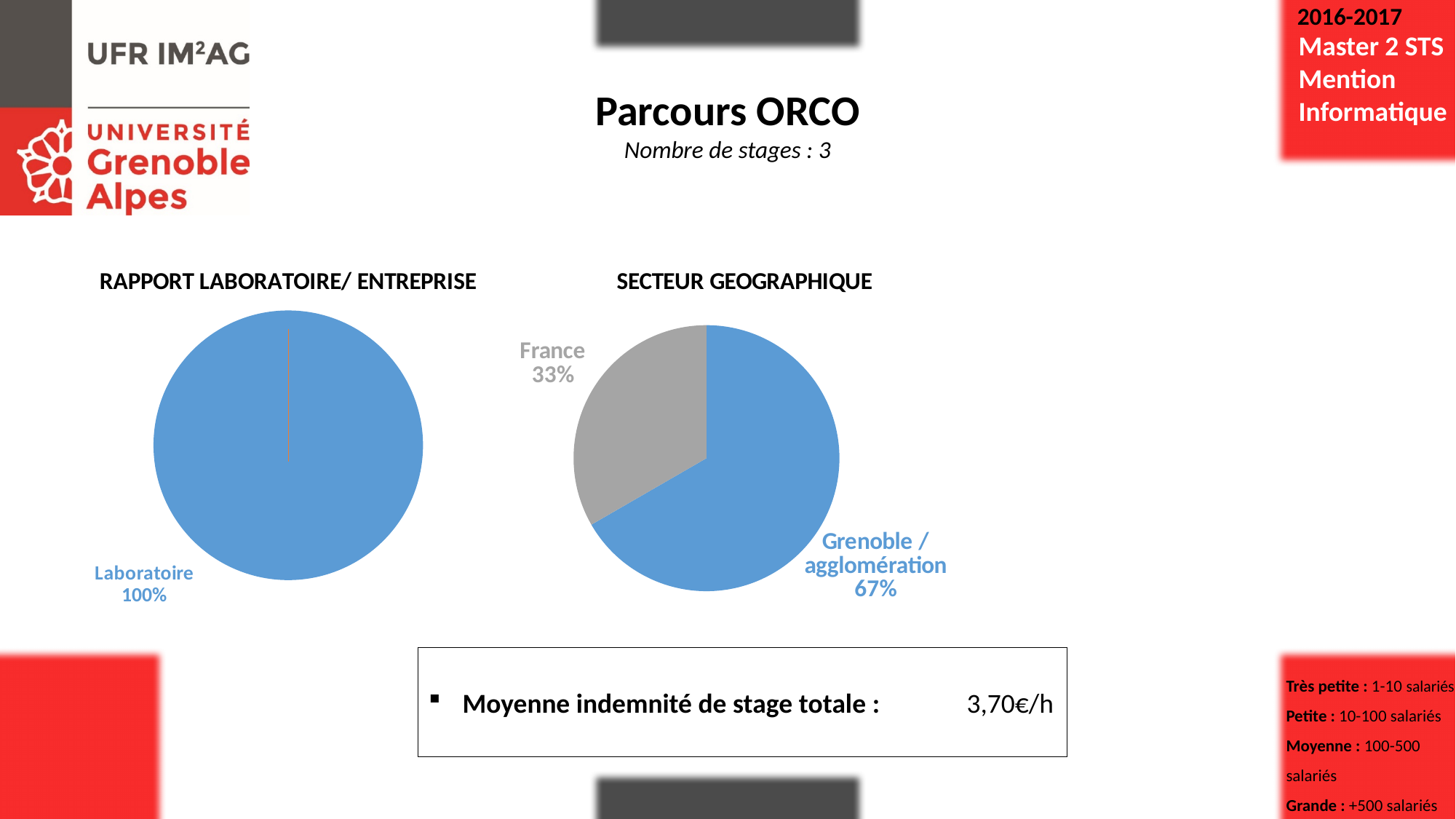
In the 'RAPPORT LABORATOIRE/ ENTREPRISE' chart, what share does 'Laboratoire' have? 100% What is the title of the chart on the left of the slide? RAPPORT LABORATOIRE/ ENTREPRISE In the 'SECTEUR GEOGRAPHIQUE' chart, what share does 'Grenoble / agglomération' have? 67% In the 'SECTEUR GEOGRAPHIQUE' chart, which slice is the largest? Grenoble / agglomération What kind of chart is the 'SECTEUR GEOGRAPHIQUE' chart? Pie chart In the 'SECTEUR GEOGRAPHIQUE' chart, what is the difference in percentage points between 'Grenoble / agglomération' and 'France'? 34 In the 'SECTEUR GEOGRAPHIQUE' chart, which slice is the smallest? France In the 'SECTEUR GEOGRAPHIQUE' chart, what share does 'France' have? 33% How many slices does the 'RAPPORT LABORATOIRE/ ENTREPRISE' chart have? 1 In the 'SECTEUR GEOGRAPHIQUE' chart, which is larger: 'France' or 'Grenoble / agglomération'? Grenoble / agglomération In the 'SECTEUR GEOGRAPHIQUE' chart, what colour is the 'France' slice? Grey How many slices does the 'SECTEUR GEOGRAPHIQUE' chart have? 2